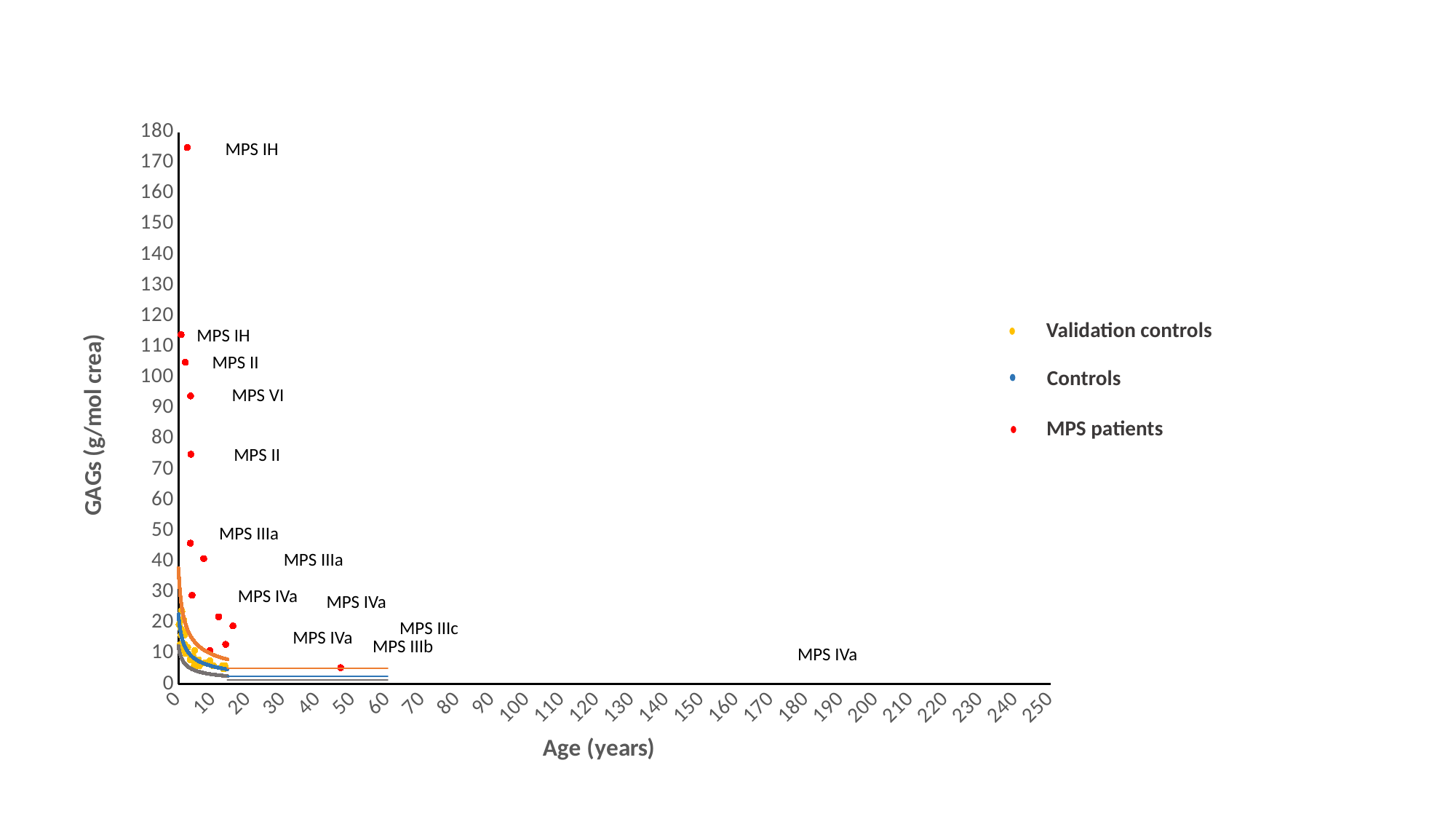
Which series has the highest plotted point on the chart? MPS patients Which MPS patient label is attached to the highest point on the chart? MPS IH Is the value for the higher MPS II point greater or less than 100? greater Is the value for the highest MPS IH point greater or less than 170? greater Is the value for the MPS VI point greater or less than 90? greater How many series does the legend list? 3 Which is higher on the chart, the MPS VI point or the higher MPS II point? MPS II What kind of chart is shown on the slide? Scatter chart What is the title of the vertical axis? GAGs (g/mol crea) What is the title of the horizontal axis? Age (years)